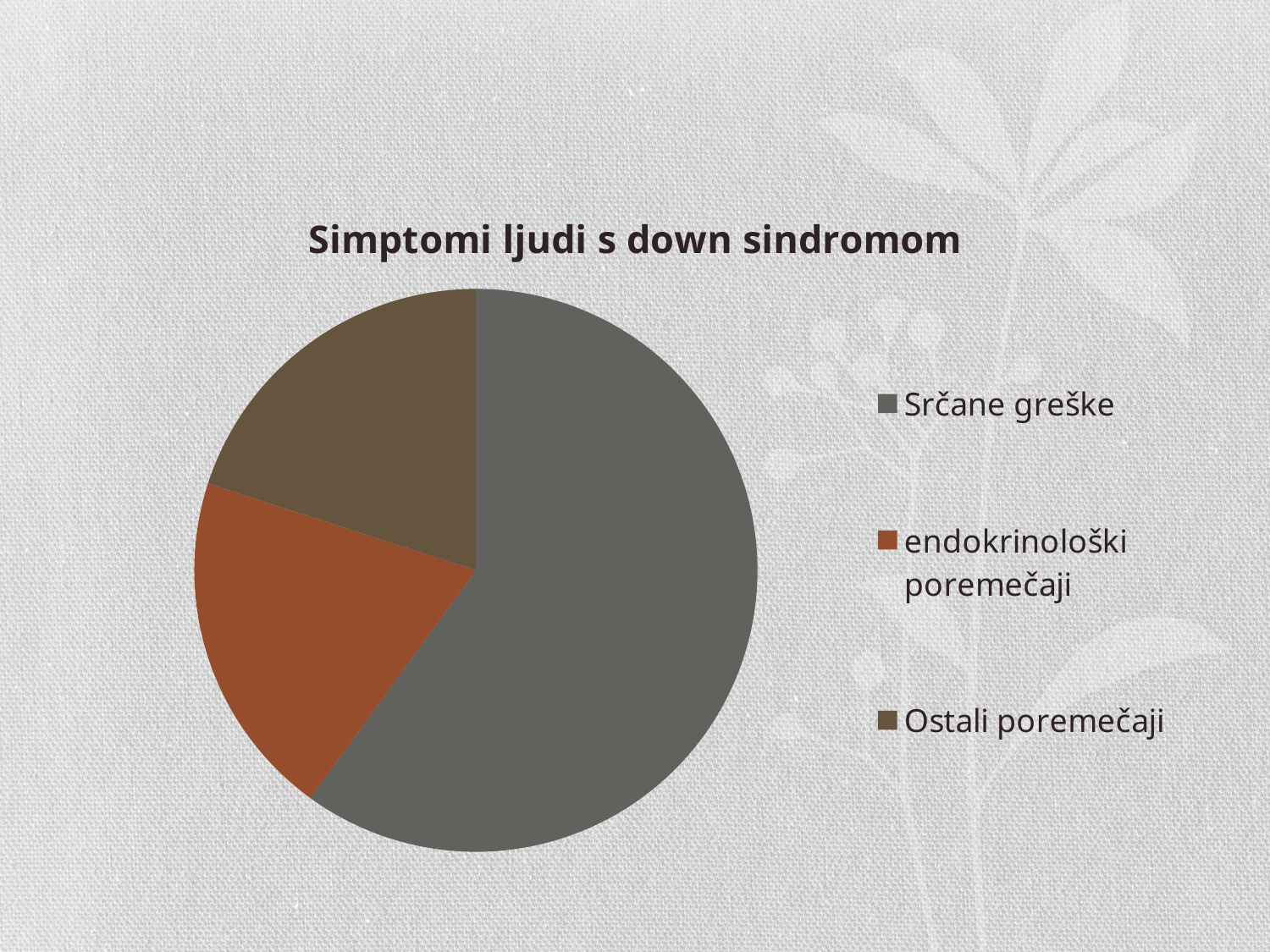
Which is larger, the slice for Srčane greške or the slice for endokrinološki poremečaji? Srčane greške Which legend entry is shown in the reddish-brown colour? endokrinološki poremečaji How many entries does the legend list? 3 What kind of chart is shown on the slide? Pie chart Does the slice for Srčane greške take up more or less than half of the pie? more Which is larger, the slice for Srčane greške or the slice for Ostali poremečaji? Srčane greške What is the title of the chart? Simptomi ljudi s down sindromom Which category has the largest slice of the pie? Srčane greške How many slices does the pie chart have? 3